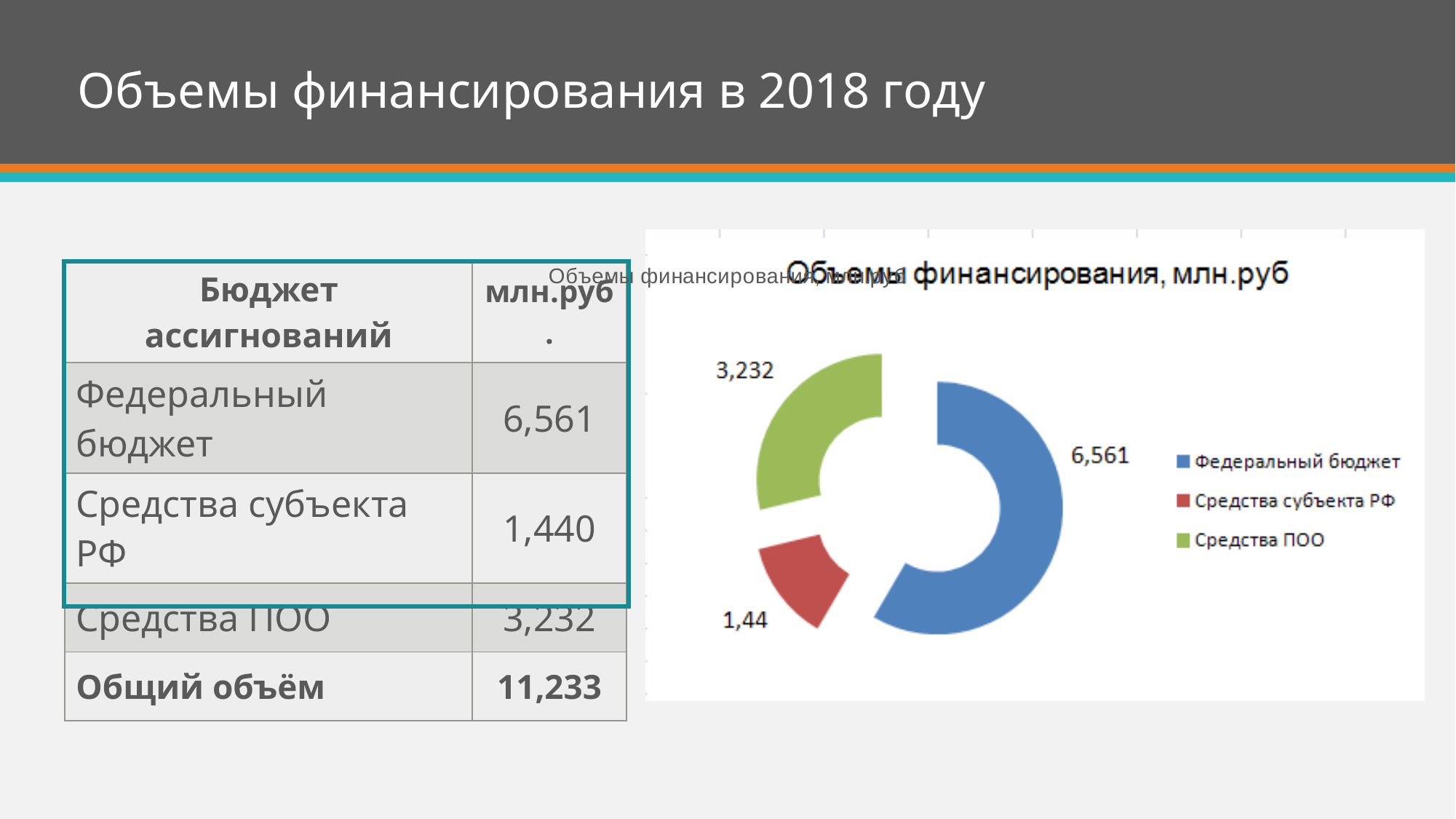
What is the title of the chart? Объемы финансирования, млн.руб What is the difference between the values for Федеральный бюджет and Средства ПОО? 3,329 Which category has the largest slice in the chart? Федеральный бюджет What colour is the slice for Средства субъекта РФ? red What is the value for Средства ПОО in the chart? 3,232 How many slices does the doughnut chart have? 3 What kind of chart is shown on the slide? doughnut chart What is the value for Федеральный бюджет in the chart? 6,561 How many series does the chart legend list? 3 What is the total of all three categories shown in the chart? 11,233 Which category has the smallest slice in the chart? Средства субъекта РФ Which is larger, Федеральный бюджет or Средства ПОО? Федеральный бюджет